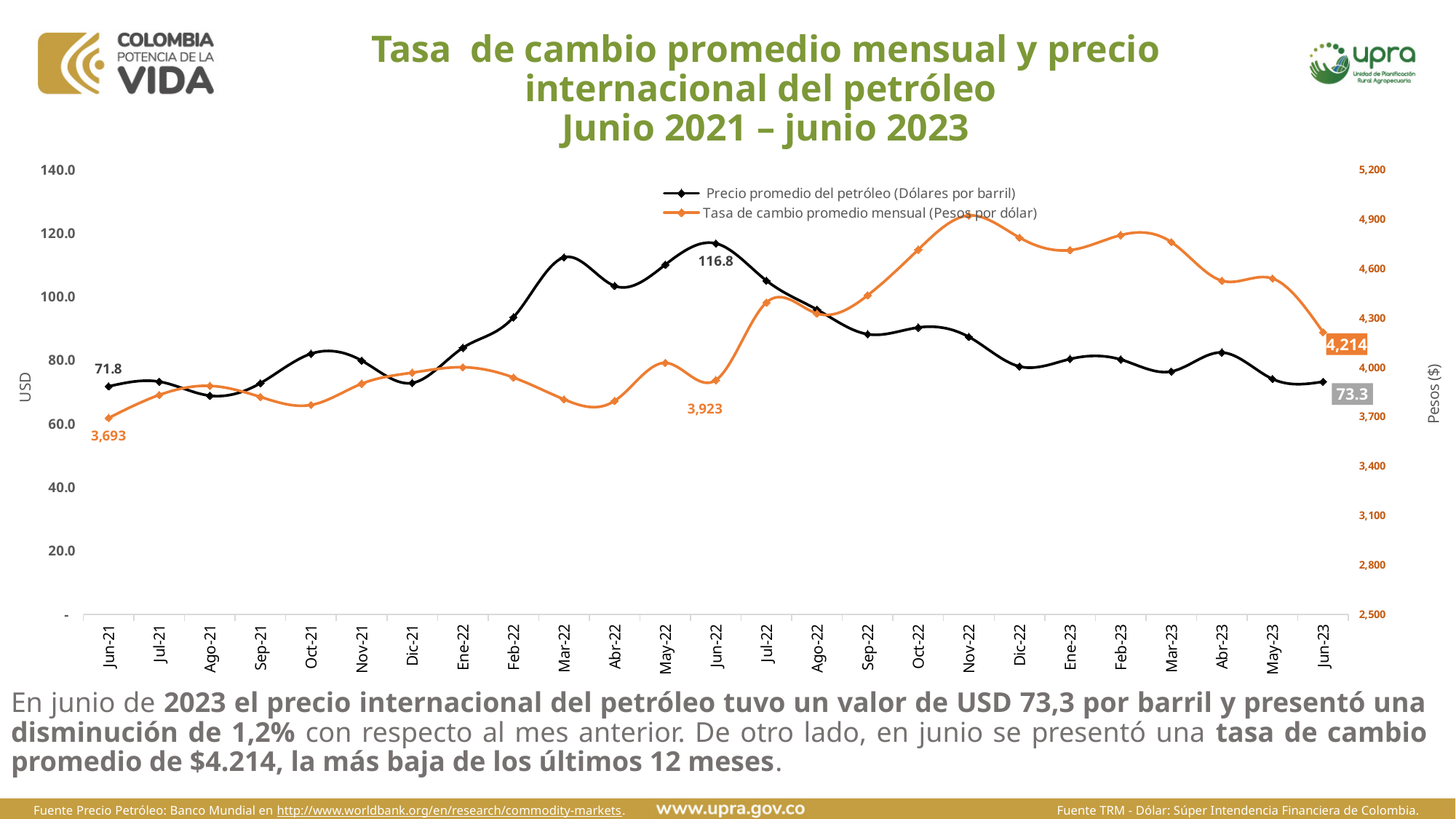
How many months are shown on the x axis? 25 By how much did the average oil price in Jun-22 exceed the price in Jun-21? 45.0 In which month was the average oil price highest? Jun-22 What was the Tasa de cambio promedio mensual (Pesos por dólar) in Jun-23? 4,214 How many series does the legend list? 2 What kind of chart is shown on the slide? line chart Is the average oil price in Mar-22 greater or less than 100.0? greater What was the Tasa de cambio promedio mensual (Pesos por dólar) in Jun-21? 3,693 What is the difference between the Tasa de cambio in Jun-23 and in Jun-21? 521 What was the average oil price (Dólares por barril) in Jun-23? 73.3 What was the average oil price (Dólares por barril) in Jun-21? 71.8 What was the average oil price (Dólares por barril) in Jun-22? 116.8